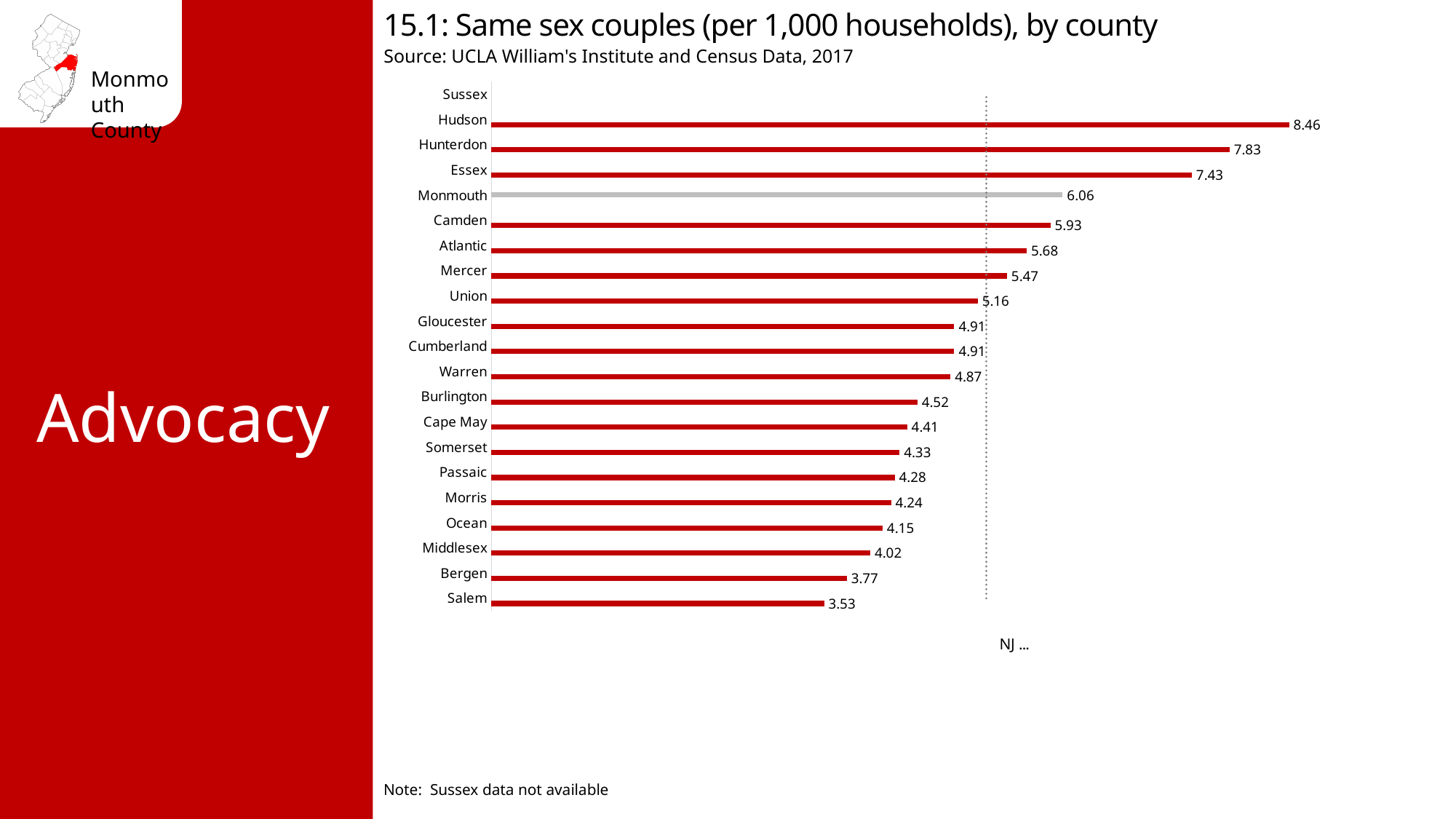
Which county has the lowest plotted value in the chart? Salem Which has a larger value, Essex or Monmouth? Essex What is the value for Monmouth in the chart? 6.06 What is the difference between the values for Monmouth and Camden? 0.13 Which county is noted as having no data available? Sussex Which has a larger value, Bergen or Middlesex? Middlesex What is the value for Salem in the chart? 3.53 What is the value for Hudson in the chart? 8.46 What kind of chart is shown on the slide? Bar chart Which county has the highest value in the chart? Hudson What is the difference between the values for Hudson and Hunterdon? 0.63 Which county's bar is shown in grey rather than red? Monmouth